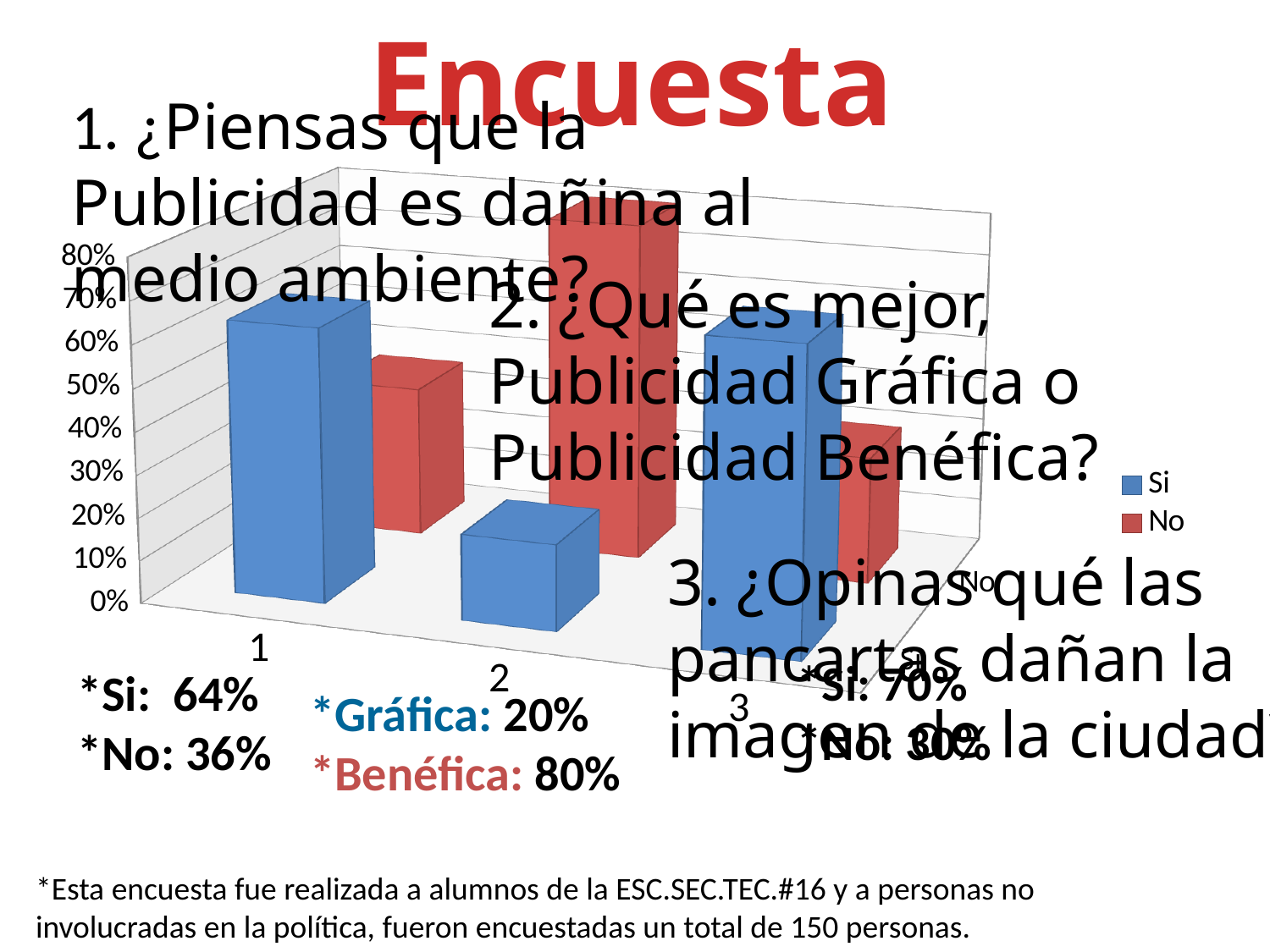
What percentage answered 'Si' to question 1? 64% How many series does the legend list? 2 Which bar in the chart is the tallest? No for category 2 (80%) How many categories are shown on the x axis of the chart? 3 What percentage chose 'Benéfica' in question 2? 80% Which colour represents the 'Si' series in the legend? blue What percentage answered 'No' to question 1? 36% Which bar in the chart is the shortest? Si for category 2 (20%) What kind of chart is shown on the slide? bar chart What percentage chose 'Gráfica' in question 2? 20% What is the difference between the Si and No percentages for question 1? 28% For category 1, which is larger, the Si bar or the No bar? Si